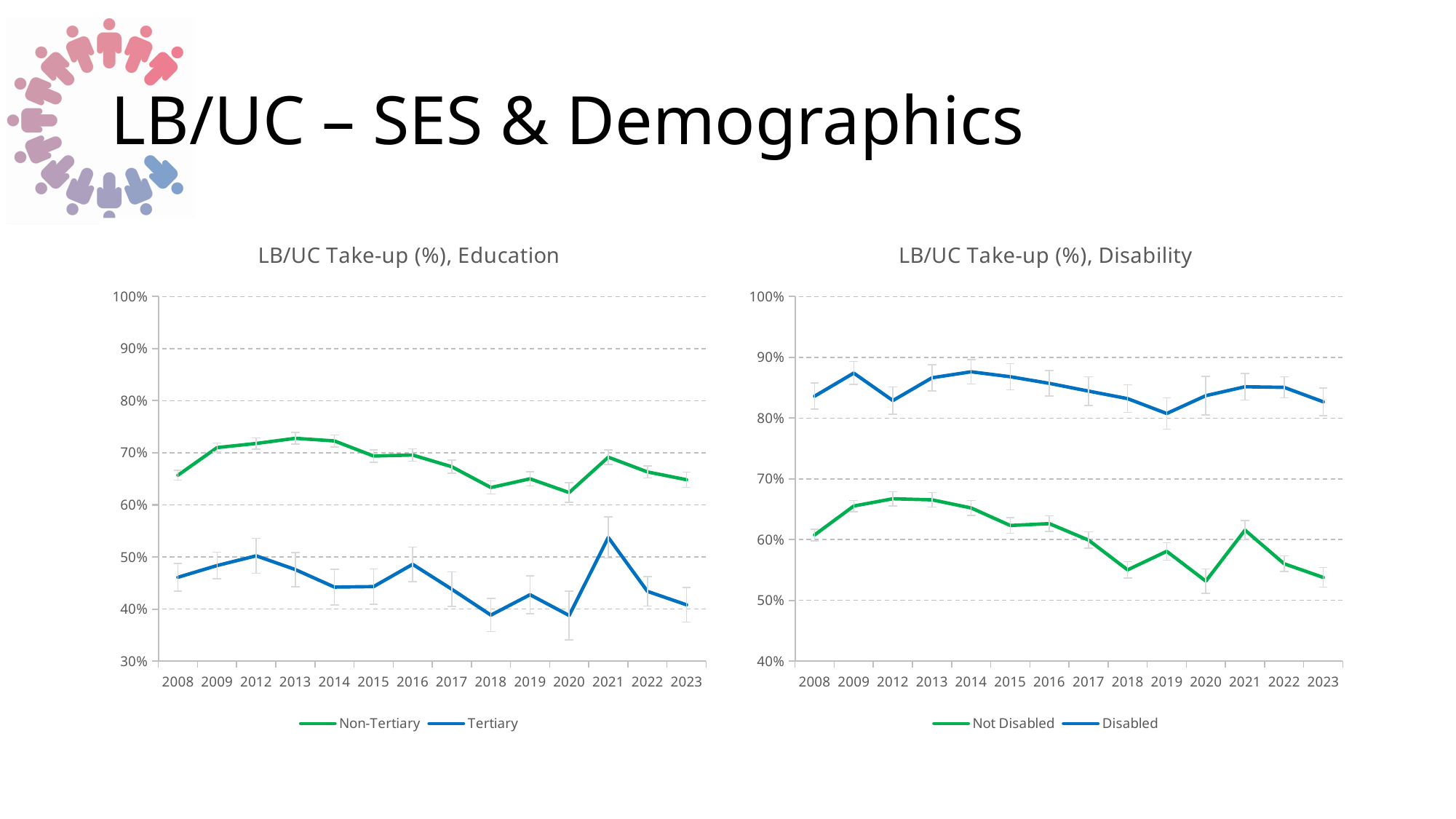
In the 'LB/UC Take-up (%), Disability' chart, in which year is the Disabled series lowest? 2019 In the 'LB/UC Take-up (%), Disability' chart, which colour is used for the Disabled series? blue In the 'LB/UC Take-up (%), Education' chart, in which year is the Tertiary series highest? 2021 What kind of chart is the 'LB/UC Take-up (%), Education' chart? line chart In the 'LB/UC Take-up (%), Disability' chart, is the Disabled value for 2014 greater or less than 80%? greater How many series does the legend of the 'LB/UC Take-up (%), Disability' chart list? 2 In the 'LB/UC Take-up (%), Education' chart, which series has the larger value in 2008, Non-Tertiary or Tertiary? Non-Tertiary In the 'LB/UC Take-up (%), Education' chart, does the Tertiary series rise or fall from 2021 to 2023? fall In the 'LB/UC Take-up (%), Disability' chart, is the Not Disabled value for 2020 greater or less than 60%? less In the 'LB/UC Take-up (%), Education' chart, is the Non-Tertiary value for 2013 greater or less than 70%? greater How many years are plotted on the x axis of the 'LB/UC Take-up (%), Education' chart? 14